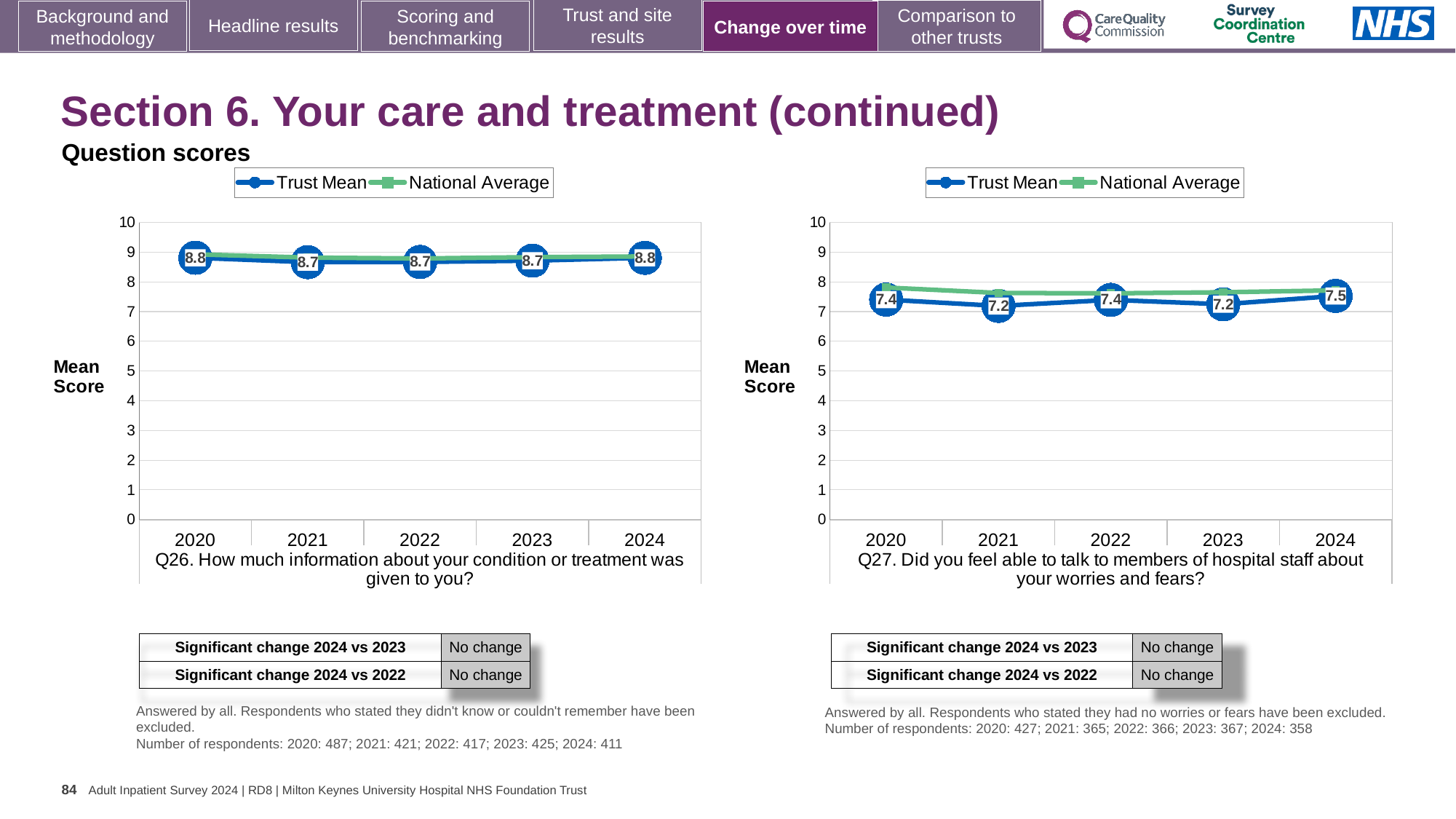
How many years are shown on the x axis of the Q26 chart? 5 How many series does the legend of the Q27 chart list? 2 On the Q27 chart, which year has the highest Trust Mean score? 2024 On the Q27 chart, what is the Trust Mean score for 2023? 7.2 On the Q27 chart, is the National Average value for 2020 greater or less than 7? greater On the Q27 chart, is the Trust Mean score higher in 2022 or in 2021? 2022 On the Q26 chart, what is the Trust Mean score for 2024? 8.8 On the Q26 chart, what is the Trust Mean score for 2021? 8.7 On the Q26 chart, what is the difference between the Trust Mean scores for 2020 and 2021? 0.1 What type of chart is used for Q26? Line chart On the Q27 chart, what is the difference between the Trust Mean scores for 2024 and 2023? 0.3 On the Q27 chart, what is the Trust Mean score for 2024? 7.5